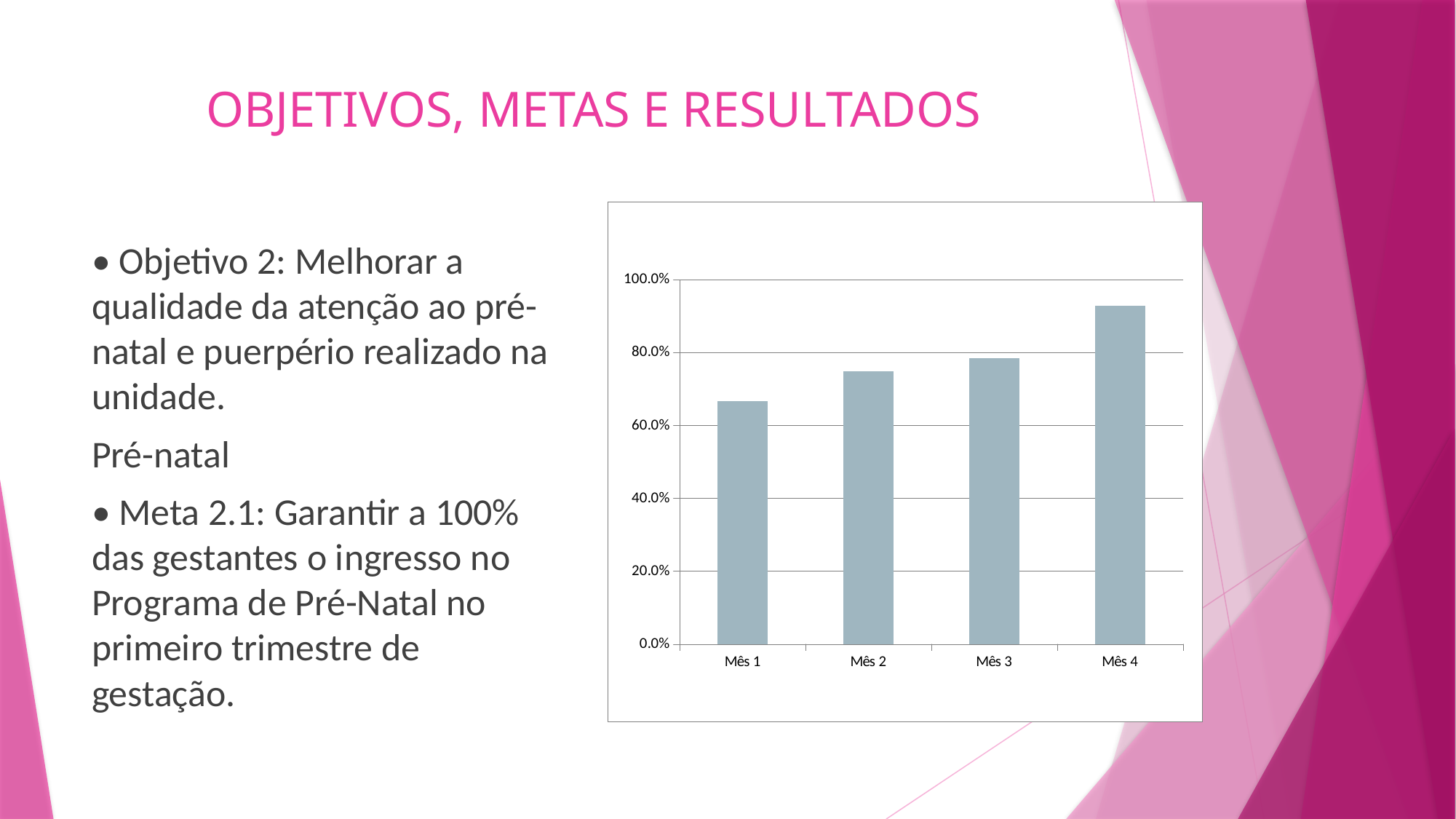
Do the values rise or fall from Mês 1 to Mês 4? rise Which is larger, the value for Mês 1 or the value for Mês 4? Mês 4 Which is larger, the value for Mês 1 or the value for Mês 2? Mês 2 Is the value for Mês 1 greater or less than 60.0%? greater How many categories are plotted on the x axis of the chart? 4 Is the value for Mês 4 greater or less than 80.0%? greater Is the value for Mês 4 greater or less than 100.0%? less What is the label of the first category on the x axis of the chart? Mês 1 Which month has the lowest bar in the chart? Mês 1 Which month has the highest bar in the chart? Mês 4 What kind of chart is shown on the slide? bar chart